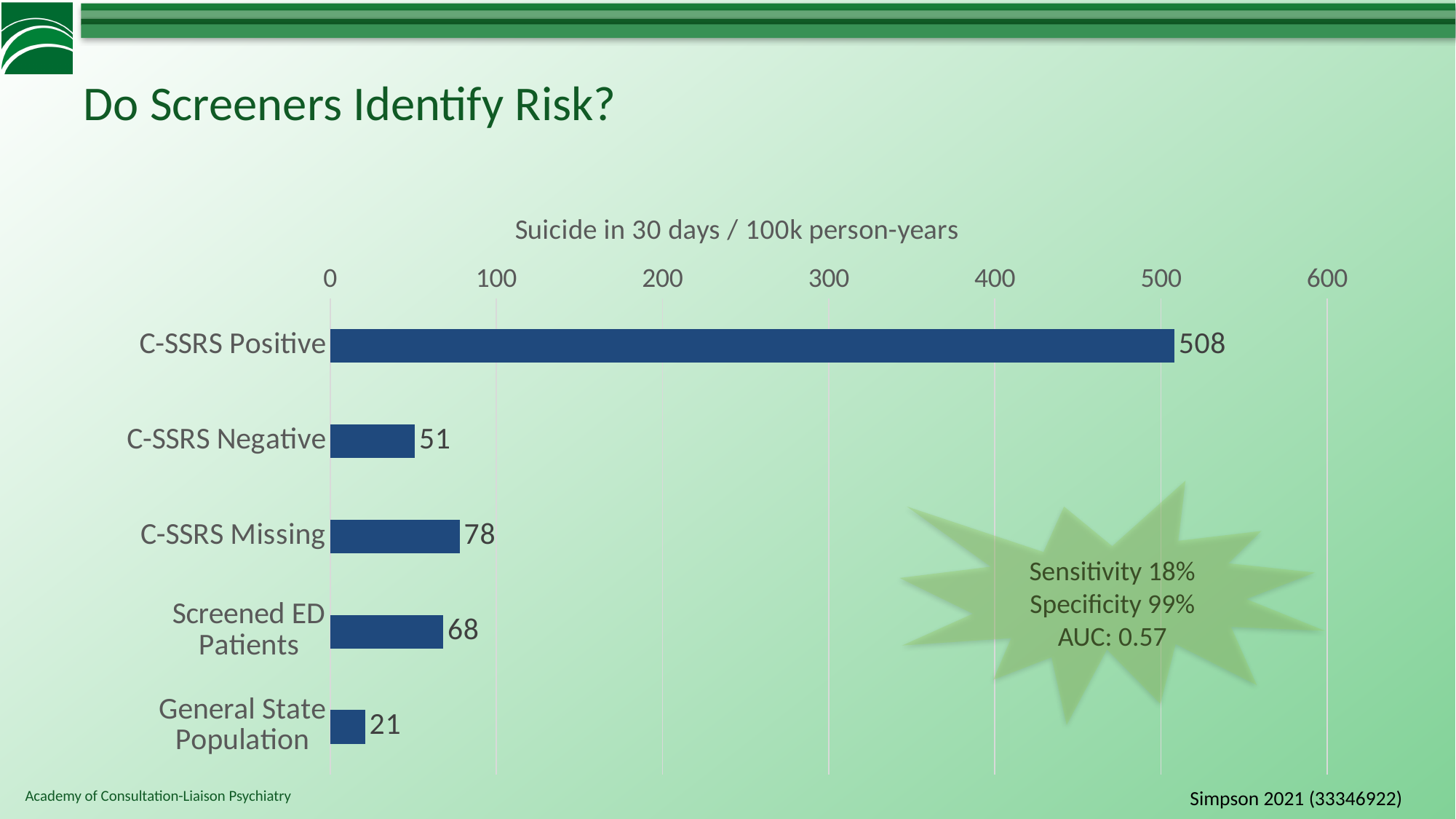
What is the value for Screened ED Patients? 68 What is the difference between the values for C-SSRS Missing and Screened ED Patients? 10 What is the value for General State Population? 21 Is the value for C-SSRS Positive greater or less than 500? greater What is the value for C-SSRS Negative? 51 What is the value for C-SSRS Positive? 508 What is the difference between the values for C-SSRS Positive and C-SSRS Negative? 457 Which category has the lowest value? General State Population How many categories are shown in the chart? 5 Which category has the highest value? C-SSRS Positive What kind of chart is shown on the slide? Bar chart Which is larger, the value for C-SSRS Missing or the value for C-SSRS Negative? C-SSRS Missing